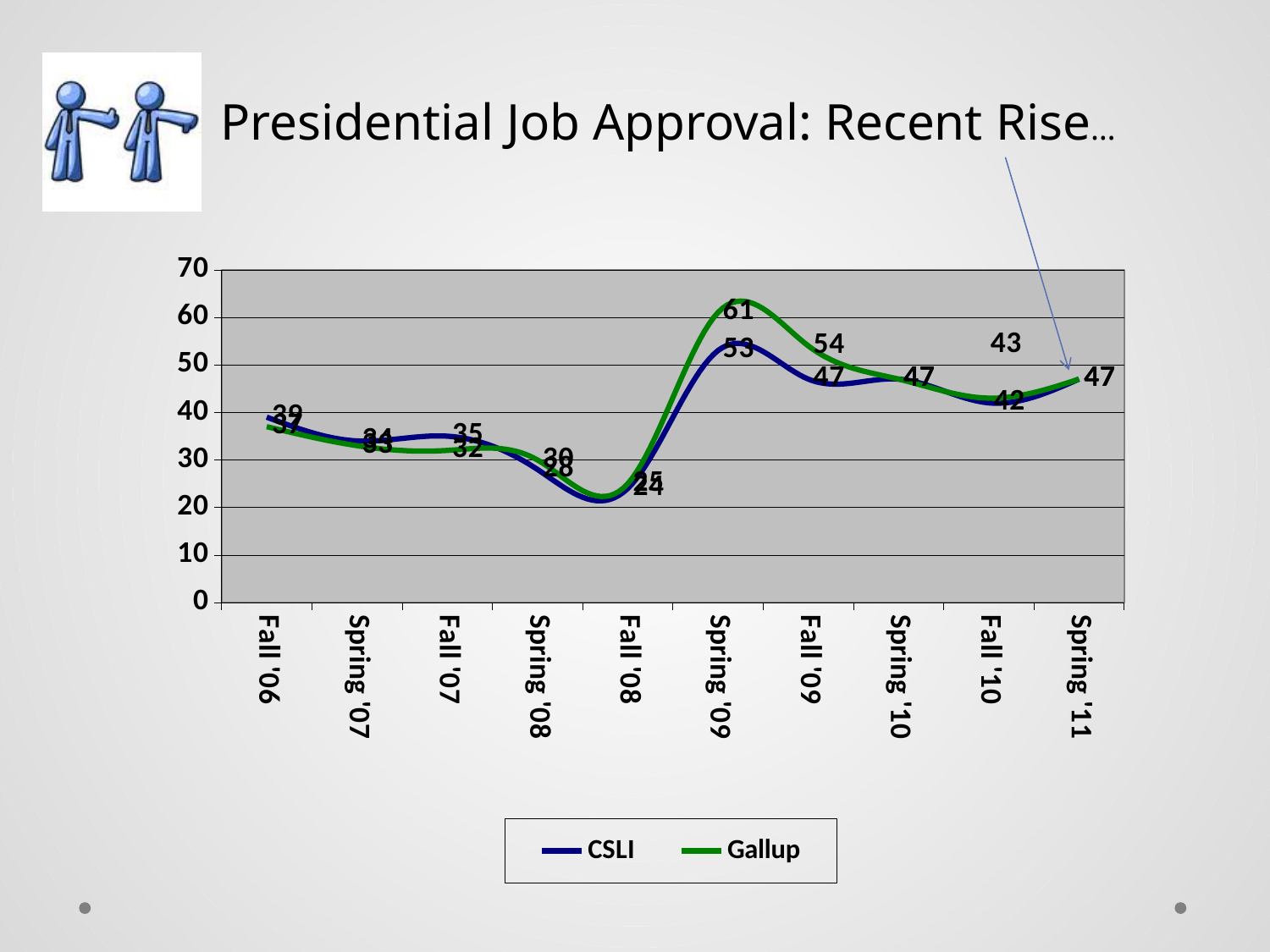
What kind of chart is shown on the slide? line chart What is the difference between the Gallup and CSLI values in Spring '09? 8 What is the Gallup value for Spring '09? 61 What is the CSLI value for Spring '09? 53 How many series does the legend list? 2 What is the Gallup value for Fall '10? 43 What is the Gallup value for Fall '09? 54 How many time points are shown on the x axis? 10 Do the values rise or fall from Fall '06 to Fall '08? fall Is the CSLI value for Fall '08 greater or less than 30? less At which time point do both series reach their lowest value? Fall '08 At which time point does the Gallup series reach its highest value? Spring '09